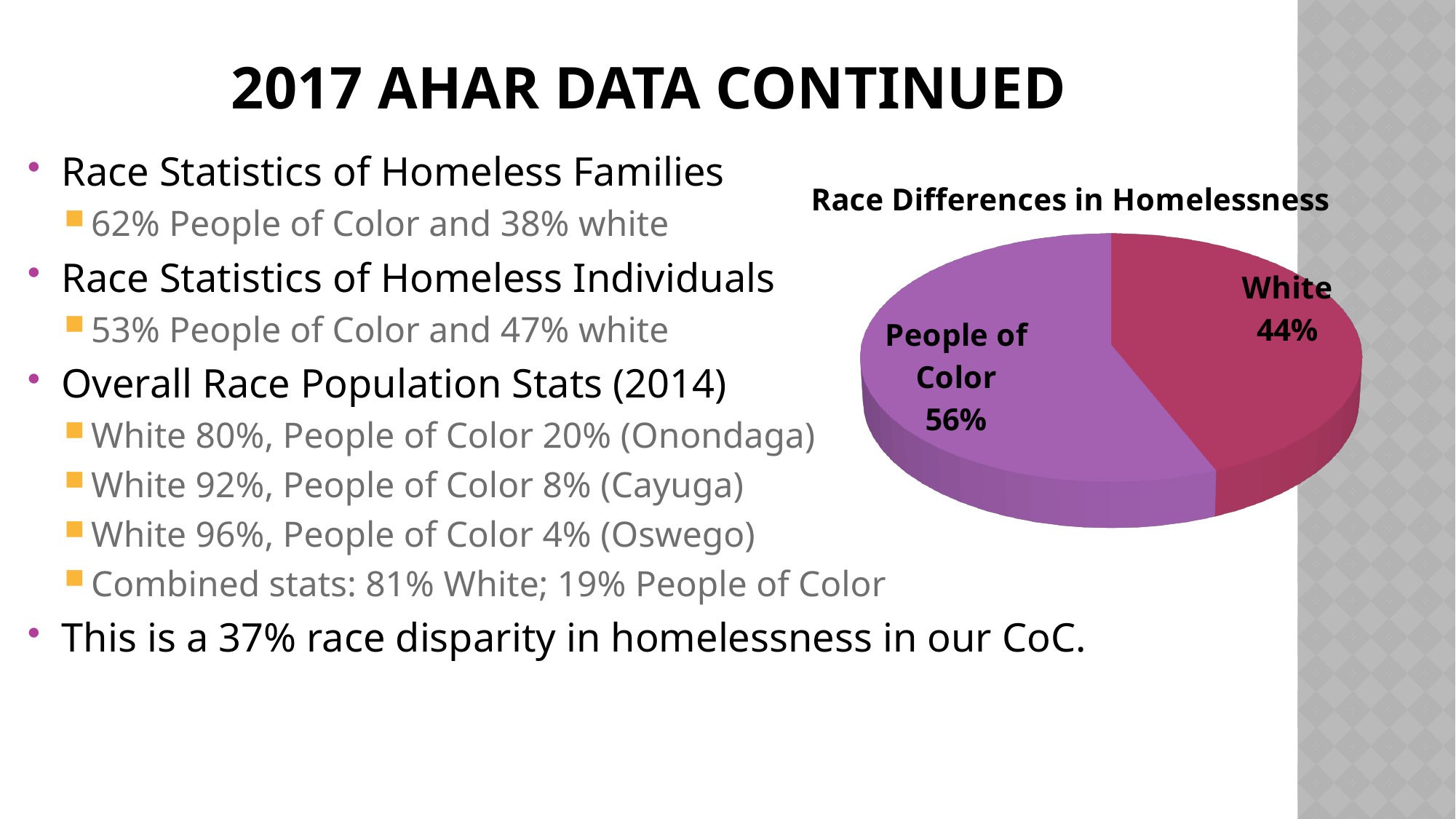
What kind of chart is shown on the slide? pie chart What colour is the People of Color slice? purple What share of the pie does White represent? 44% Which slice of the pie is the smallest? White What is the difference in percentage points between the People of Color slice and the White slice? 12% What share of the pie does People of Color represent? 56% What is the title of the chart? Race Differences in Homelessness How many slices does the pie chart have? 2 Which slice of the pie is the largest? People of Color Which is larger, the People of Color slice or the White slice? People of Color